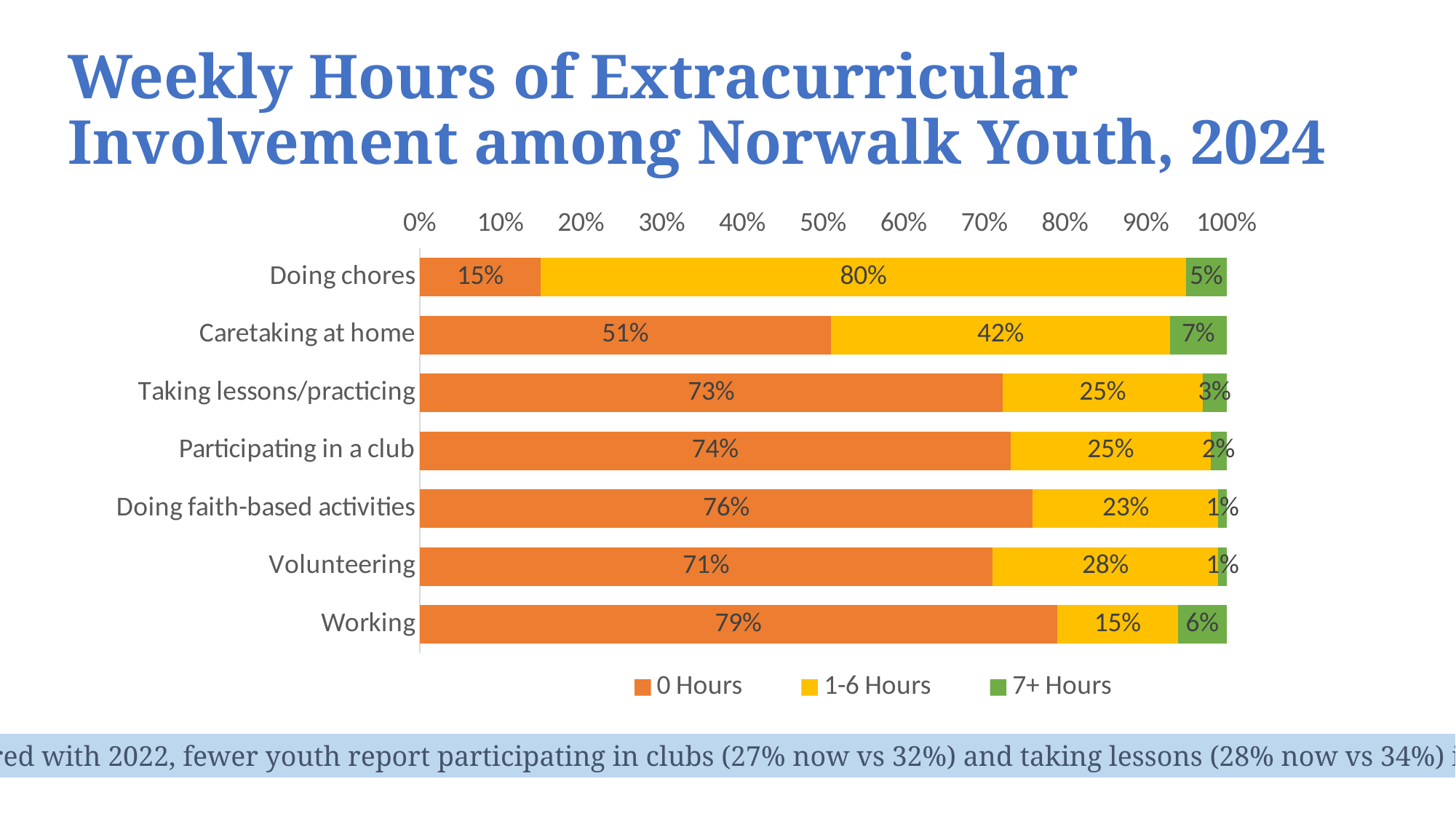
Which colour represents the 1-6 Hours series? Yellow What percentage of youth report 7+ hours of working? 6% Which activity has the highest share of youth reporting 0 hours? Working Which activity has the lowest share of youth reporting 0 hours? Doing chores What kind of chart is shown on the slide? Stacked bar chart What is the difference between the 0 Hours share for Working and the 0 Hours share for Volunteering? 8% Which activity has the highest share of youth reporting 1-6 hours? Doing chores What percentage of youth report 1-6 hours of caretaking at home? 42% How many activities are shown on the chart? 7 Which is larger: the 7+ Hours share for Caretaking at home or for Doing chores? Caretaking at home What percentage of Norwalk youth report 0 hours of doing chores per week? 15% How many series does the legend list? 3